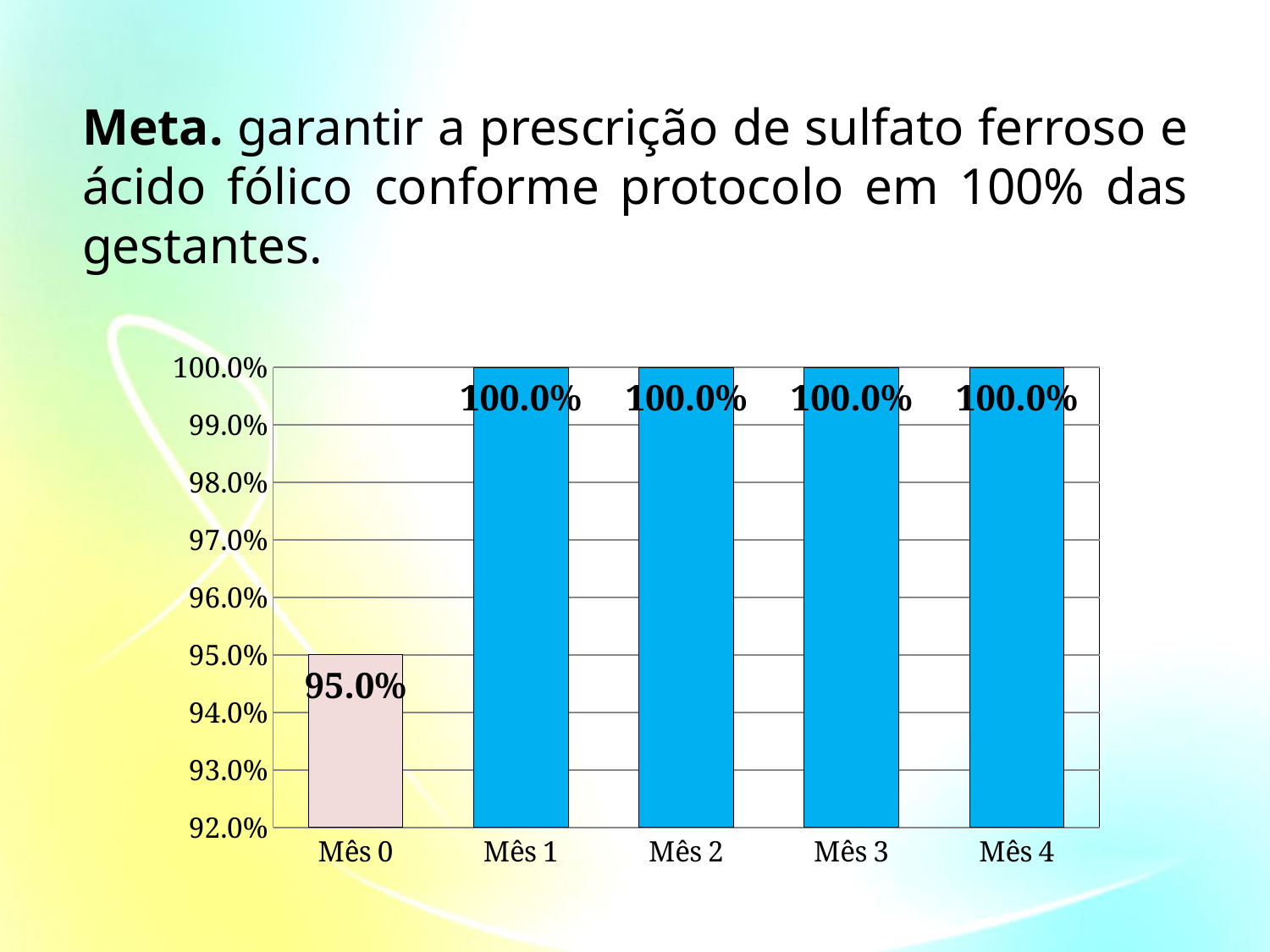
What is the value for Mês 2? 100.0% What kind of chart is shown on the slide? bar chart What is the value for Mês 4? 100.0% What is the difference between the values for Mês 1 and Mês 0? 5.0% What is the lowest value shown on the y axis? 92.0% Which is larger, the value for Mês 0 or the value for Mês 3? Mês 3 What is the value for Mês 0? 95.0% Which category has the lowest value? Mês 0 Is the value for Mês 0 greater or less than 96.0%? less Do the values rise or fall from Mês 0 to Mês 1? rise How many categories have a value of 100.0%? 4 How many categories are shown on the x axis? 5